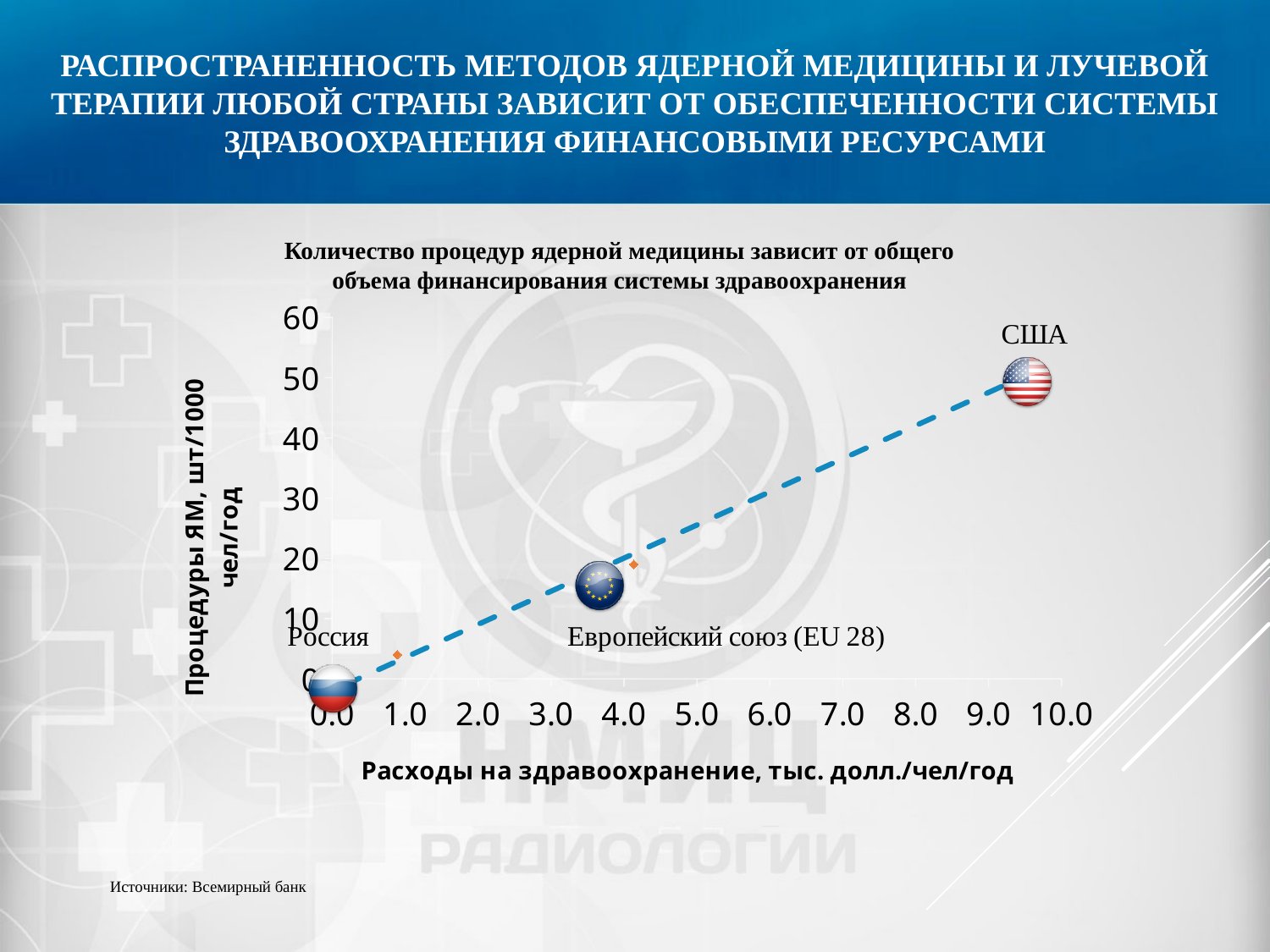
Is the number of procedures for Россия greater or less than 10? less Do the number of procedures rise or fall as healthcare spending increases along the x axis? Rise Which country or region has the highest number of nuclear medicine procedures per 1000 people per year? США Is the healthcare spending value for Россия greater or less than 2.0 thousand dollars per person per year? less Which has more nuclear medicine procedures per 1000 people: Европейский союз (EU 28) or Россия? Европейский союз (EU 28) What is the label of the x axis of the chart? Расходы на здравоохранение, тыс. долл./чел/год Is the number of procedures for США greater or less than 40? greater What kind of chart is shown on the slide? Scatter chart Which country or region has the lowest number of nuclear medicine procedures per 1000 people per year? Россия How many data points (countries/regions) are plotted on the chart? 3